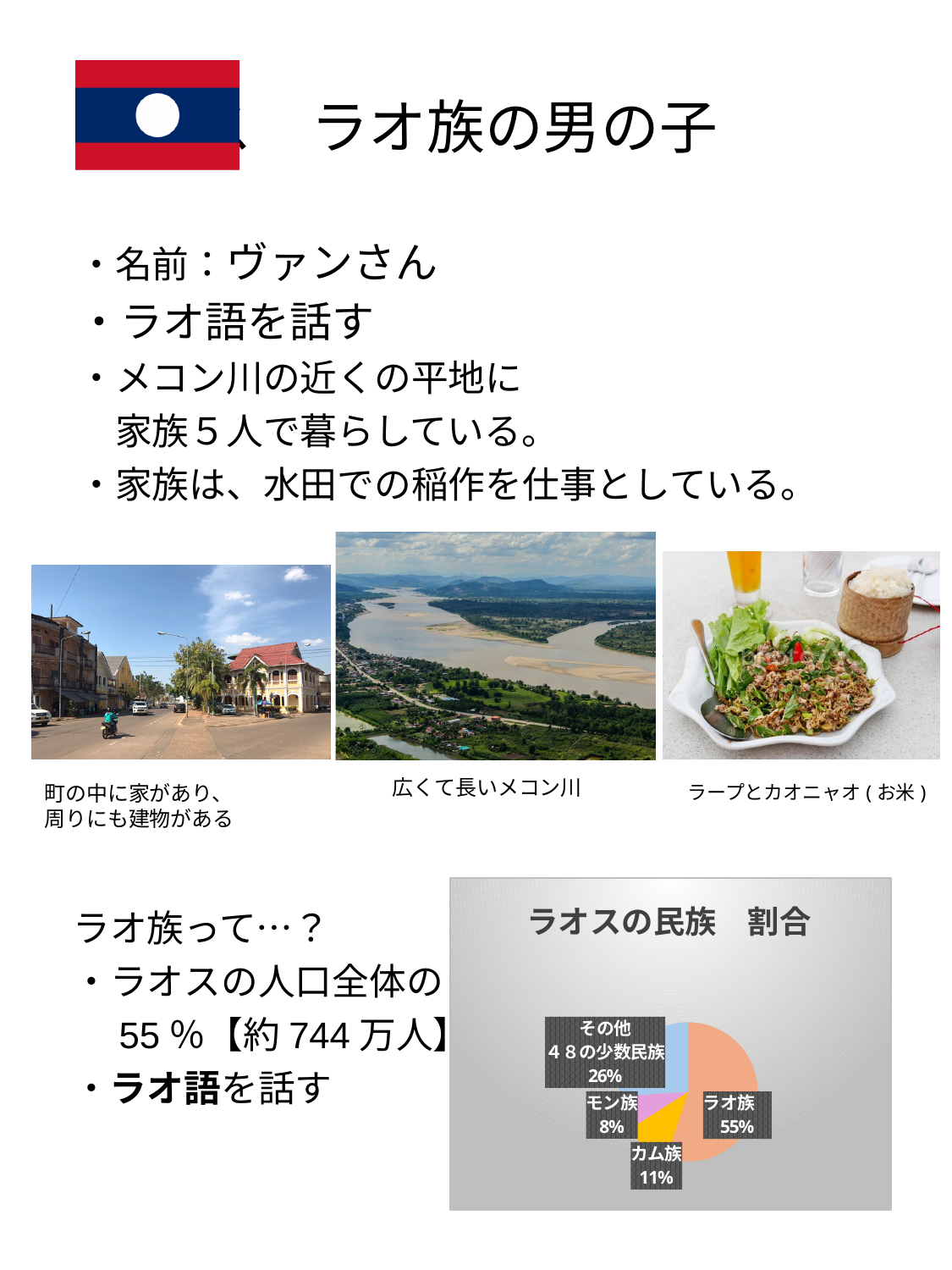
Which has a larger share, カム族 or モン族? カム族 What is the title of the chart? ラオスの民族 割合 What is the difference in percentage points between カム族 and モン族? 3 What share of the pie does ラオ族 have? 55% What type of chart is shown on the slide? pie chart What is the difference in percentage points between ラオ族 and その他48の少数民族? 29 What share of the pie does カム族 have? 11% What share of the pie does その他48の少数民族 have? 26% How many slices does the pie chart have? 4 Which ethnic group has the largest share in the pie chart? ラオ族 Which ethnic group has the smallest share in the pie chart? モン族